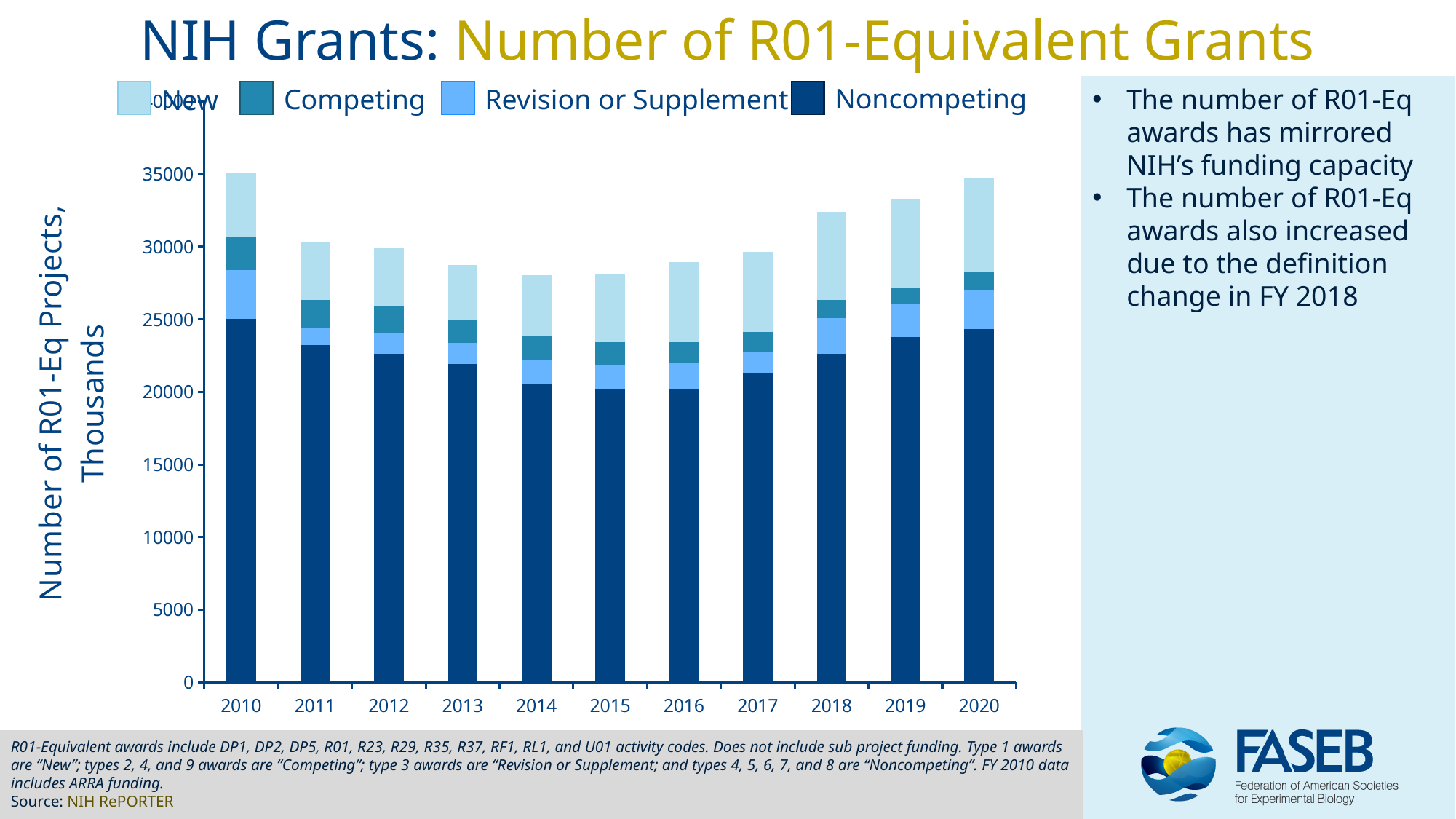
Is the Noncompeting value for 2013 greater or less than 20000? greater What kind of chart is shown on the slide? Stacked bar chart Which year has the taller total bar, 2017 or 2018? 2018 Is the total height of the bar for 2018 greater or less than 30000? greater Which year has the larger Noncompeting segment, 2016 or 2020? 2020 Is the Noncompeting value for 2019 greater or less than 25000? less What is the label on the vertical axis of the chart? Number of R01-Eq Projects, Thousands How many series does the chart legend list? 4 Do the total bar heights rise or fall from 2014 to 2020? rise Which series is shown in the darkest blue at the bottom of each bar? Noncompeting How many years are shown on the x axis of the chart? 11